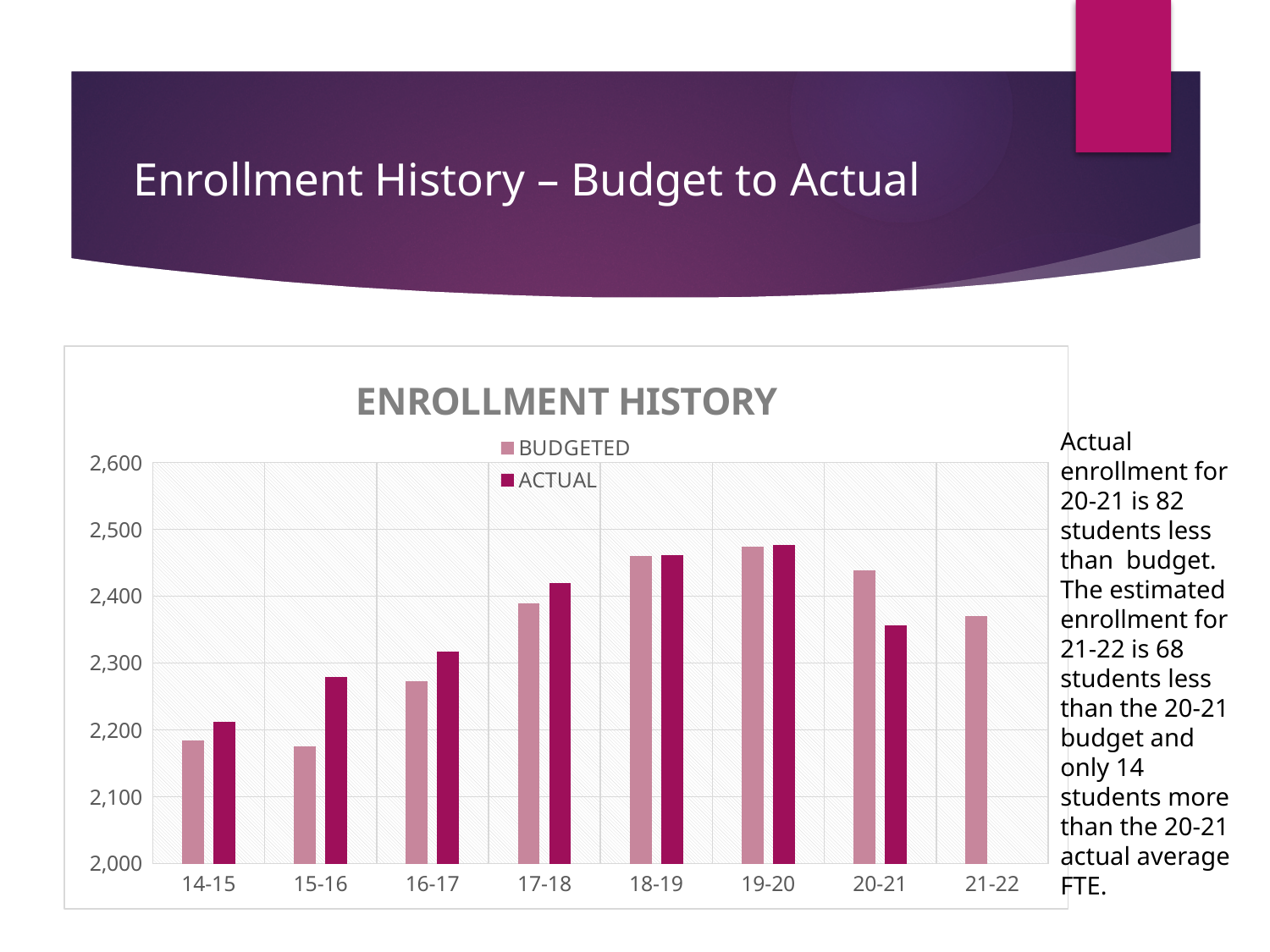
Is the ACTUAL value for 14-15 greater or less than 2,300? less What are the two legend entries of the Enrollment History chart? BUDGETED and ACTUAL What kind of chart is shown on the slide? bar chart How many series does the legend of the Enrollment History chart list? 2 For 20-21, which is larger, the BUDGETED or the ACTUAL value? BUDGETED Which school year has the lowest ACTUAL enrollment? 14-15 How many school years are shown on the x axis of the Enrollment History chart? 8 Is the BUDGETED value for 19-20 greater or less than 2,400? greater Is the ACTUAL value for 20-21 greater or less than 2,400? less For 15-16, which is larger, the BUDGETED or the ACTUAL value? ACTUAL Do the ACTUAL values rise or fall from 14-15 to 19-20? rise